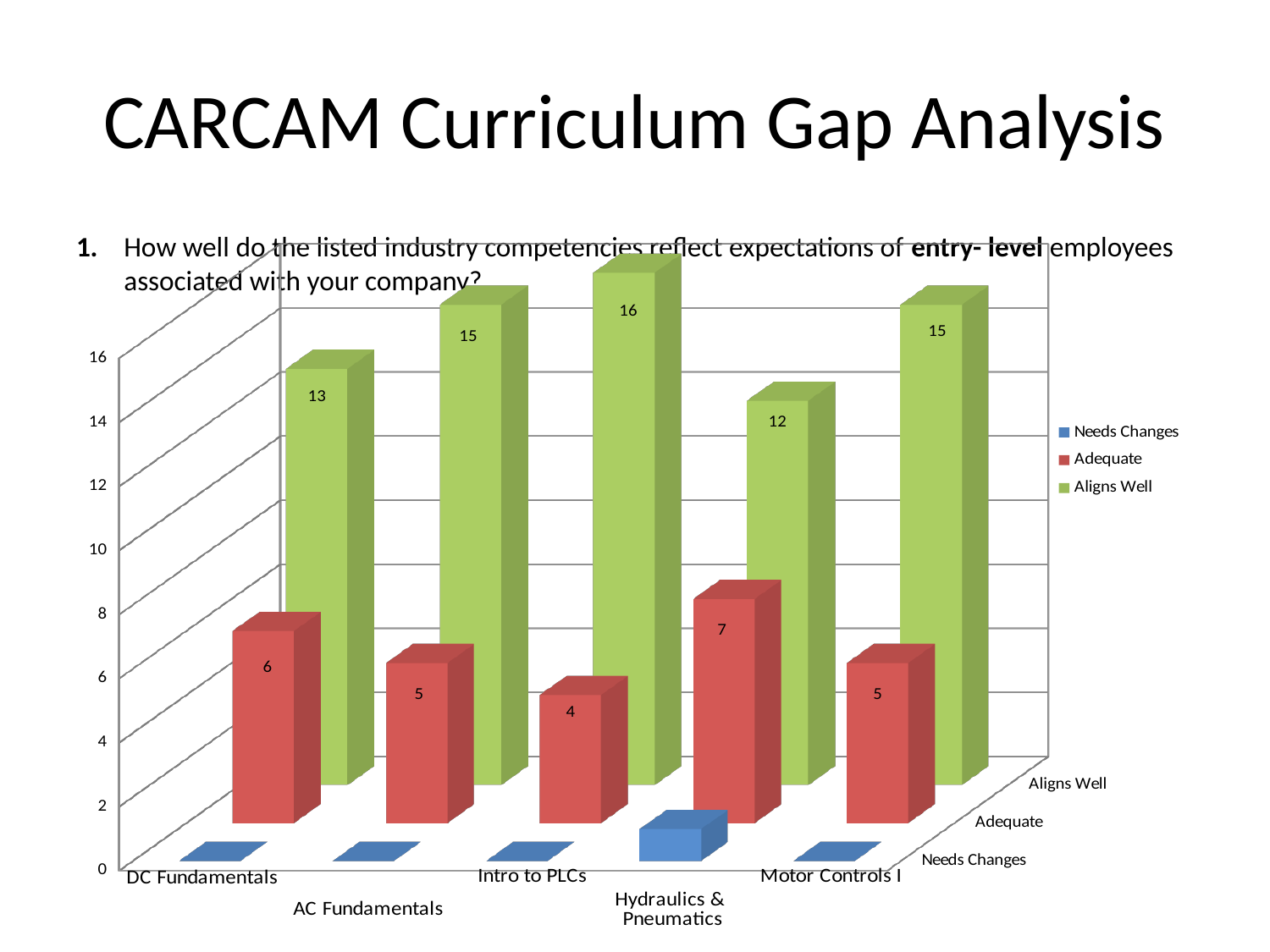
What is the Adequate value for Hydraulics & Pneumatics? 7 What is the Aligns Well value for Intro to PLCs? 16 How many categories are shown on the x axis? 5 How many series does the legend list? 3 Which is larger, the Adequate value for DC Fundamentals or for AC Fundamentals? DC Fundamentals What is the difference between the Aligns Well values for Intro to PLCs and Hydraulics & Pneumatics? 4 What is the Aligns Well value for DC Fundamentals? 13 Which category has the highest Aligns Well value? Intro to PLCs What kind of chart is shown on the slide? bar chart Which category has the lowest Adequate value? Intro to PLCs Is the Aligns Well value for Motor Controls I greater or less than 14? greater Which category has the lowest Aligns Well value? Hydraulics & Pneumatics